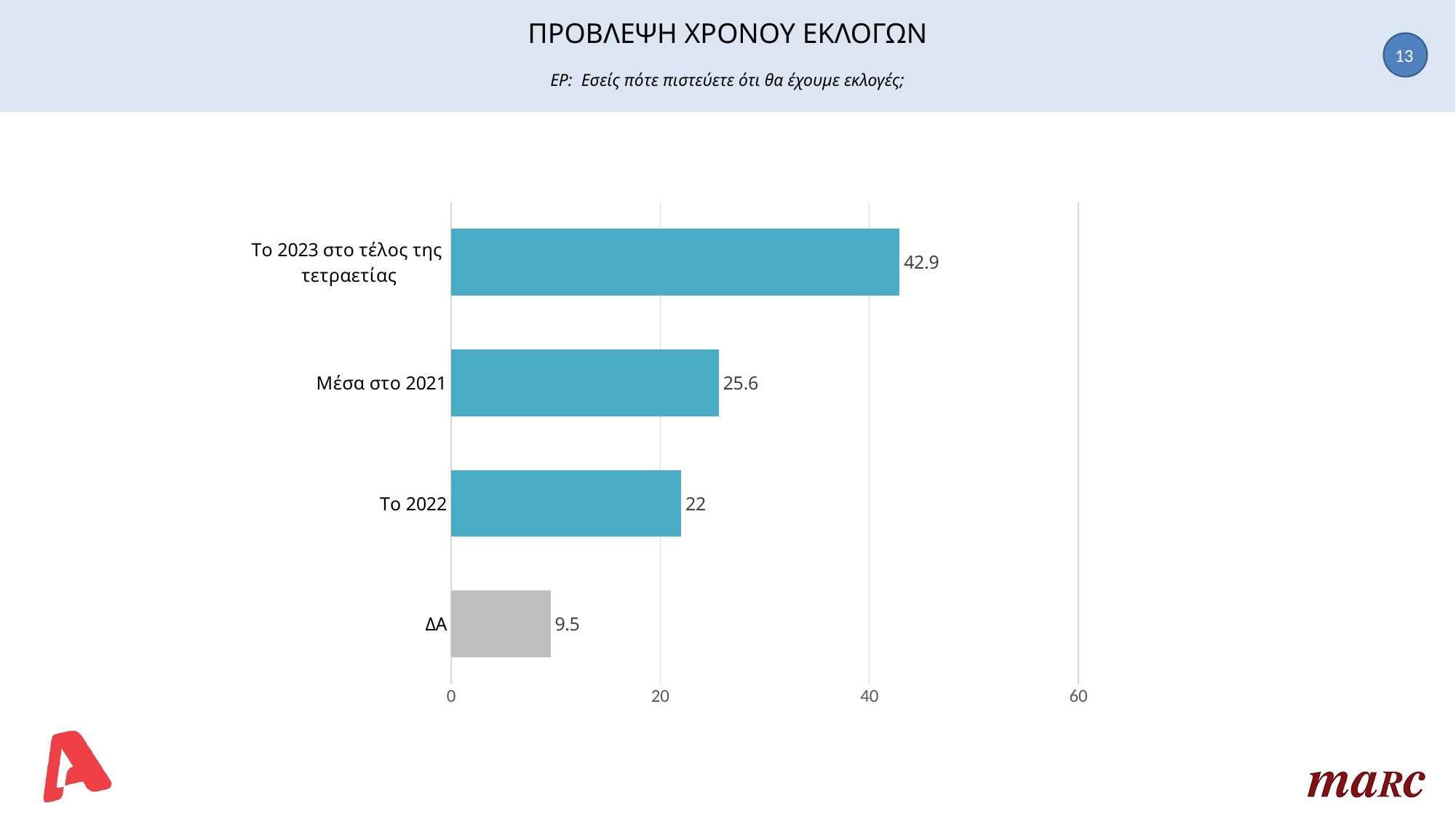
What is the value for 'Το 2023 στο τέλος της τετραετίας'? 42.9 Which category has the lowest value? ΔΑ Which is larger, the value for 'Το 2022' or the value for 'ΔΑ'? Το 2022 What is the difference between the values for 'Μέσα στο 2021' and 'Το 2022'? 3.6 What is the value for 'Μέσα στο 2021'? 25.6 What is the difference between the values for 'Το 2023 στο τέλος της τετραετίας' and 'Μέσα στο 2021'? 17.3 How many categories are shown in the chart? 4 What is the value for 'Το 2022'? 22 What is the value for 'ΔΑ'? 9.5 Is the value for 'Το 2023 στο τέλος της τετραετίας' greater or less than 40? greater What kind of chart is shown on the slide? bar chart Which category has the highest value? Το 2023 στο τέλος της τετραετίας